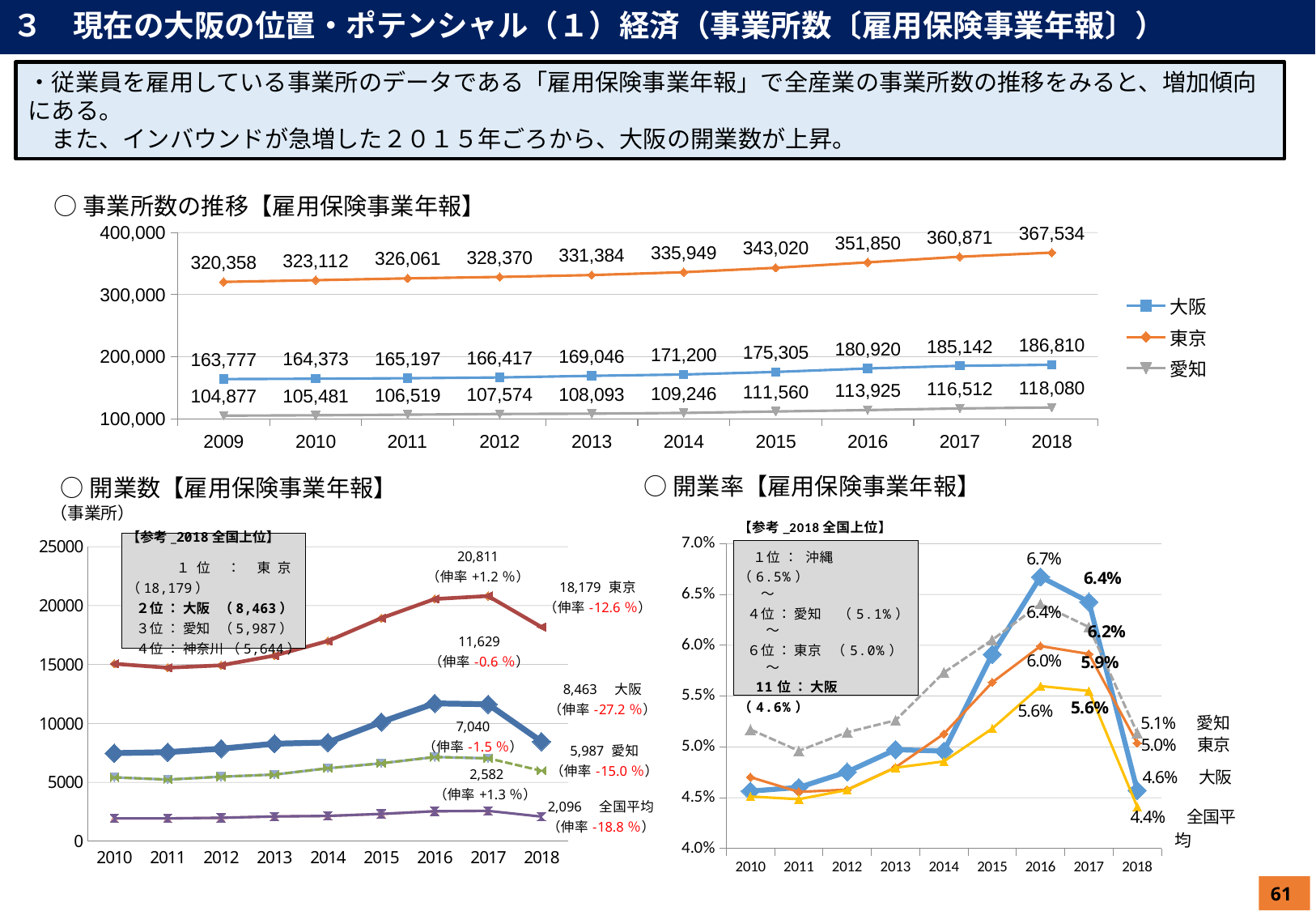
In the 事業所数の推移 chart, what is the value for 大阪 in 2009? 163,777 In the 開業率 chart, which is larger in 2018, 愛知 or 東京? 愛知 In the 事業所数の推移 chart, do the values for 愛知 rise or fall from 2009 to 2018? rise In the 事業所数の推移 chart, which series has the highest values? 東京 What kind of chart is the 事業所数の推移 chart? line chart In the 事業所数の推移 chart, by how much did the value for 大阪 increase from 2009 to 2018? 23,033 In the 開業数 chart, what is the value for 大阪 in 2018? 8,463 In the 開業率 chart, what is the value for 大阪 in 2016? 6.7% How many series does the legend of the 事業所数の推移 chart list? 3 In the 事業所数の推移 chart, what is the value for 東京 in 2018? 367,534 How many years are shown on the x axis of the 事業所数の推移 chart? 10 In the 開業数 chart, what is the difference between 東京 and 大阪 in 2018? 9,716